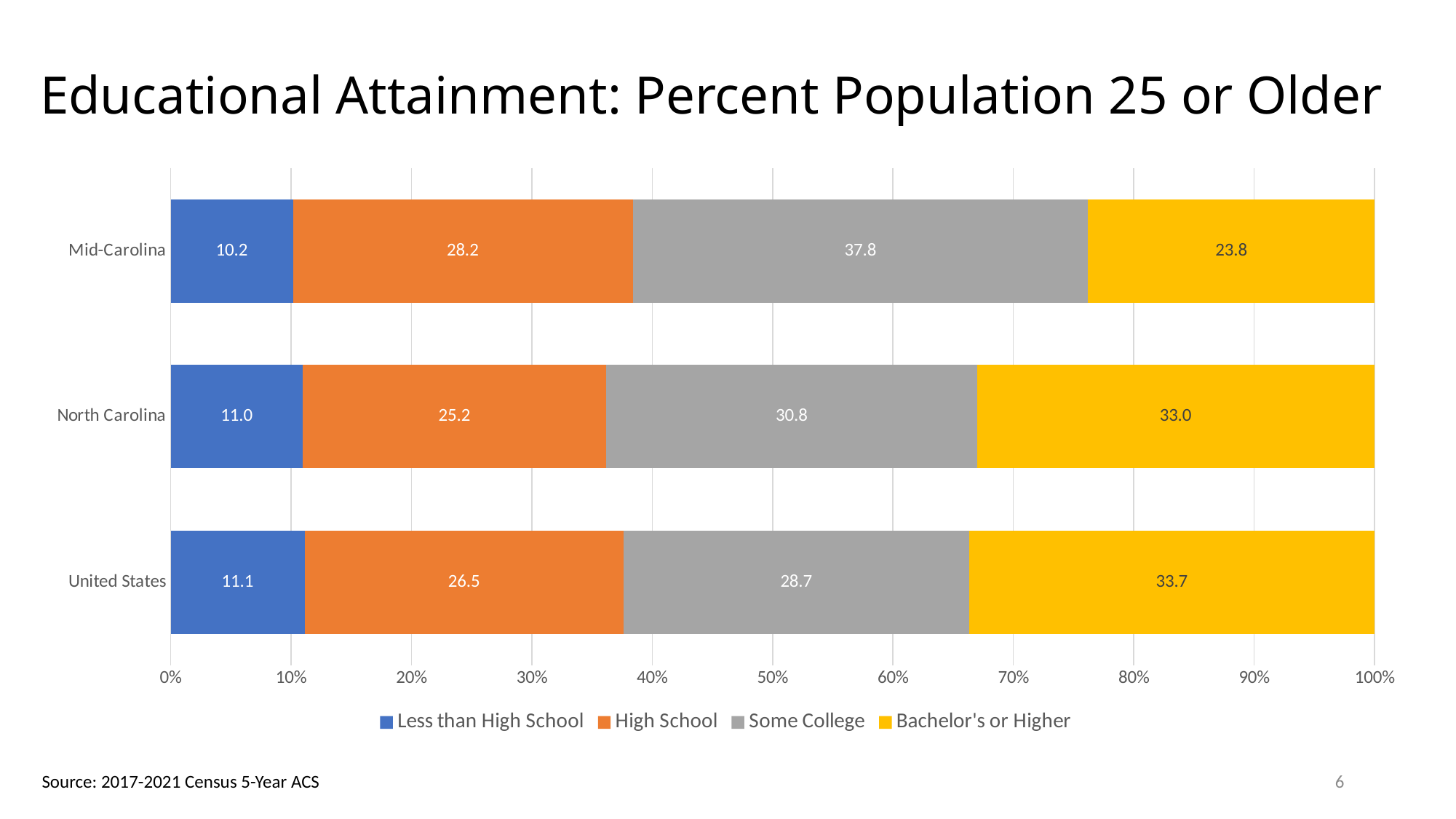
What kind of chart is shown? Stacked bar chart What is the Less than High School value for the United States? 11.1 Which category has the lowest Less than High School value? Mid-Carolina What is the difference between the Some College values for Mid-Carolina and North Carolina? 7.0 What is the total of the stacked bar for North Carolina? 100.0 What is the Bachelor's or Higher value for North Carolina? 33.0 What is the title of the chart? Educational Attainment: Percent Population 25 or Older How many categories are shown on the y axis? 3 Which is larger, the High School value for Mid-Carolina or for the United States? Mid-Carolina How many series does the legend list? 4 Which category has the highest Bachelor's or Higher value? United States What is the Some College value for Mid-Carolina? 37.8